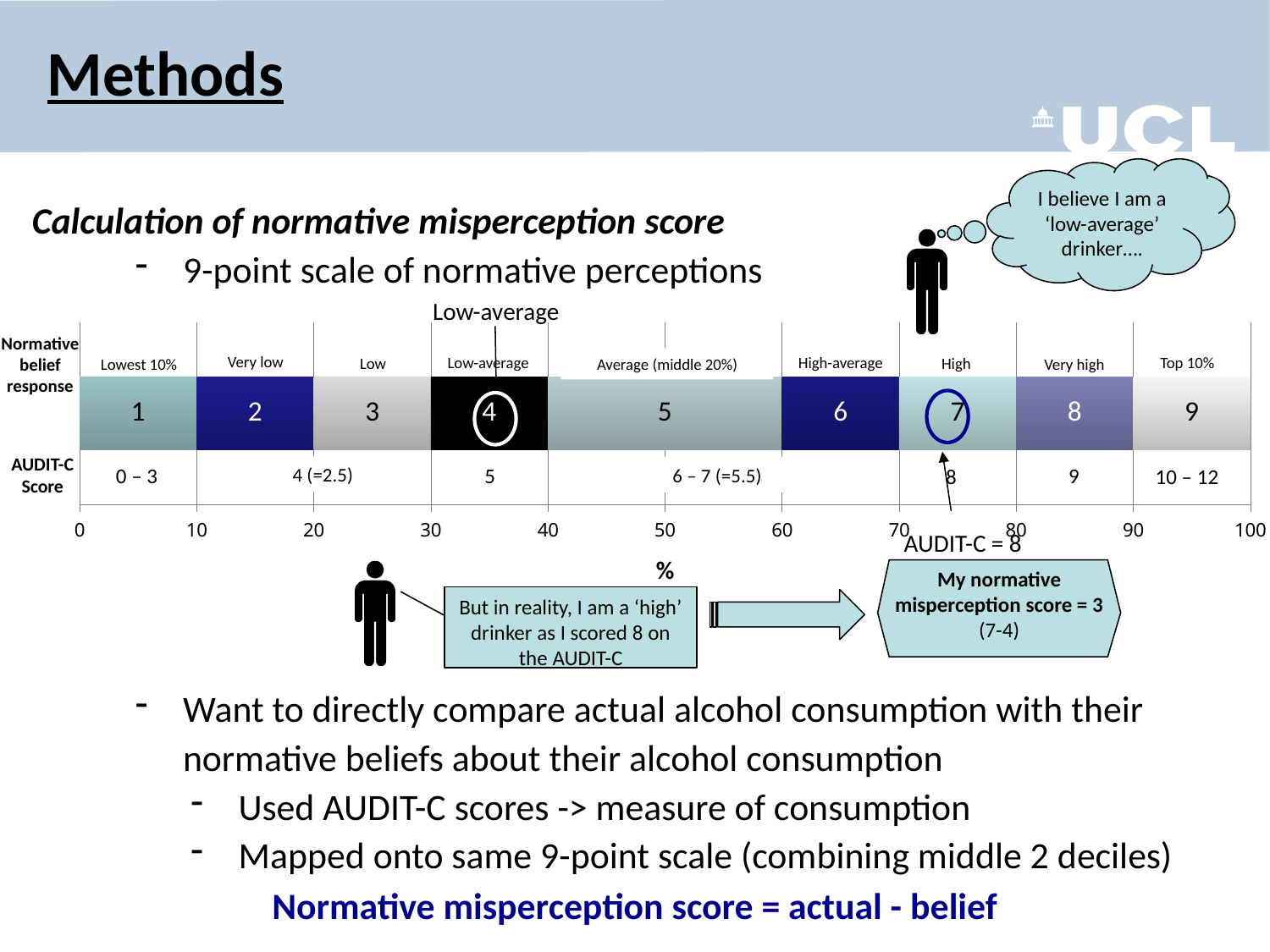
What AUDIT-C score range is mapped to segment 1 (Lowest 10%)? 0 – 3 How many numbered segments does the normative belief scale bar contain? 9 What is the highest value shown on the horizontal percentage axis? 100 Between which two axis values does segment 5 (Average) span? 40 and 60 What normative misperception score is shown in the example box? 3 Which segment number is labelled 'Average (middle 20%)'? 5 Which normative belief response label corresponds to segment 4 on the scale? Low-average What AUDIT-C score is mapped to the 'High' segment (7)? 8 What unit is shown on the horizontal axis of the scale bar? % Which segment of the scale bar is the widest along the percentage axis? 5 (Average (middle 20%)) Which segment number is circled in blue on the scale bar? 7 What AUDIT-C score range is mapped to segment 9 (Top 10%)? 10 – 12